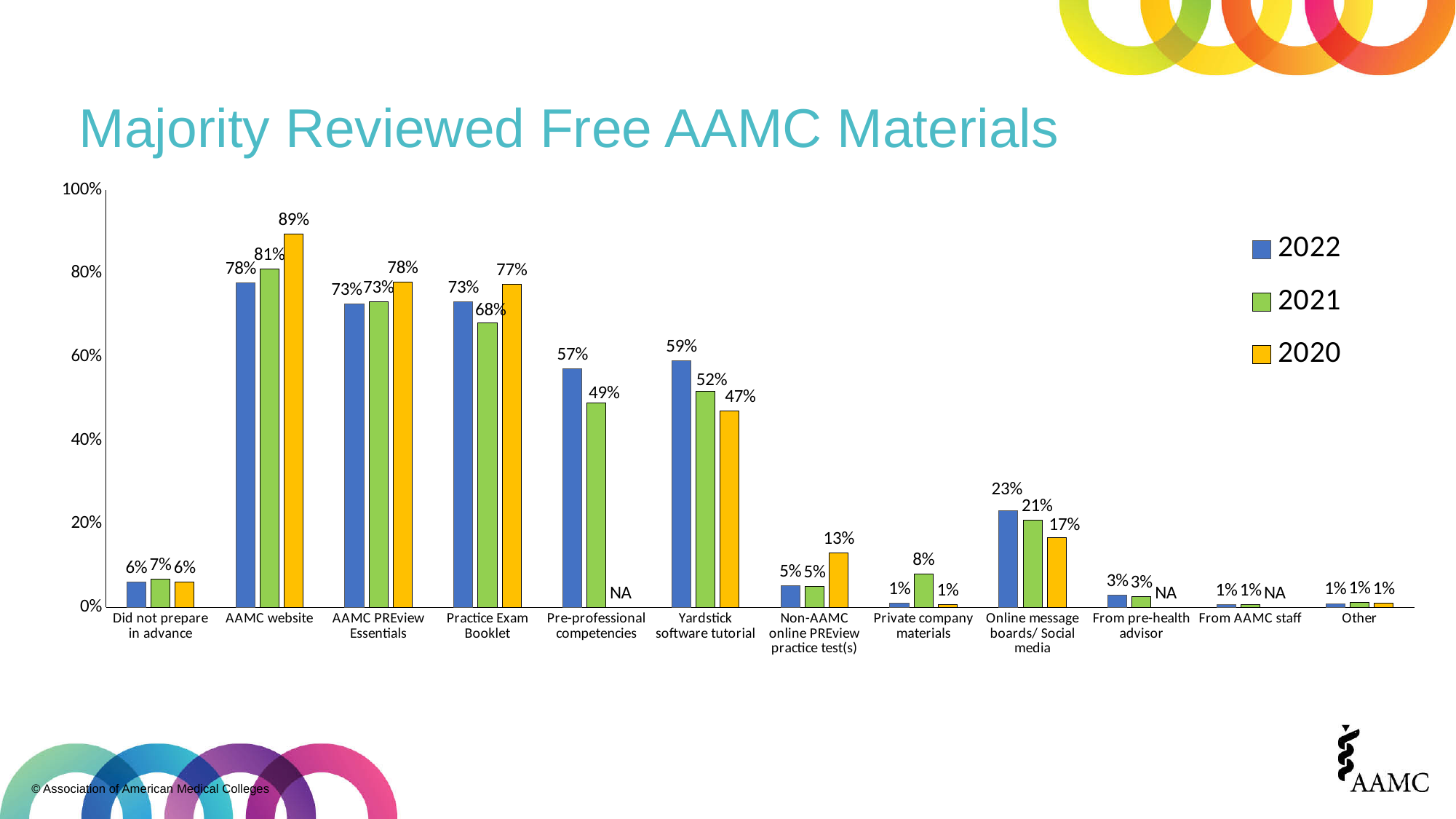
What is the title of the chart? Majority Reviewed Free AAMC Materials What is the 2021 value for Private company materials? 8% What is the difference between the 2020 and 2022 values for AAMC website? 11% Which is larger for Practice Exam Booklet: the 2021 value or the 2020 value? 2020 What is the 2020 value for AAMC website? 89% What is the 2020 value for Pre-professional competencies? NA How many categories are shown on the x axis? 12 What is the 2022 value for Yardstick software tutorial? 59% Which category has the highest 2022 value? AAMC website What kind of chart is shown on the slide? Bar chart How many series does the legend list? 3